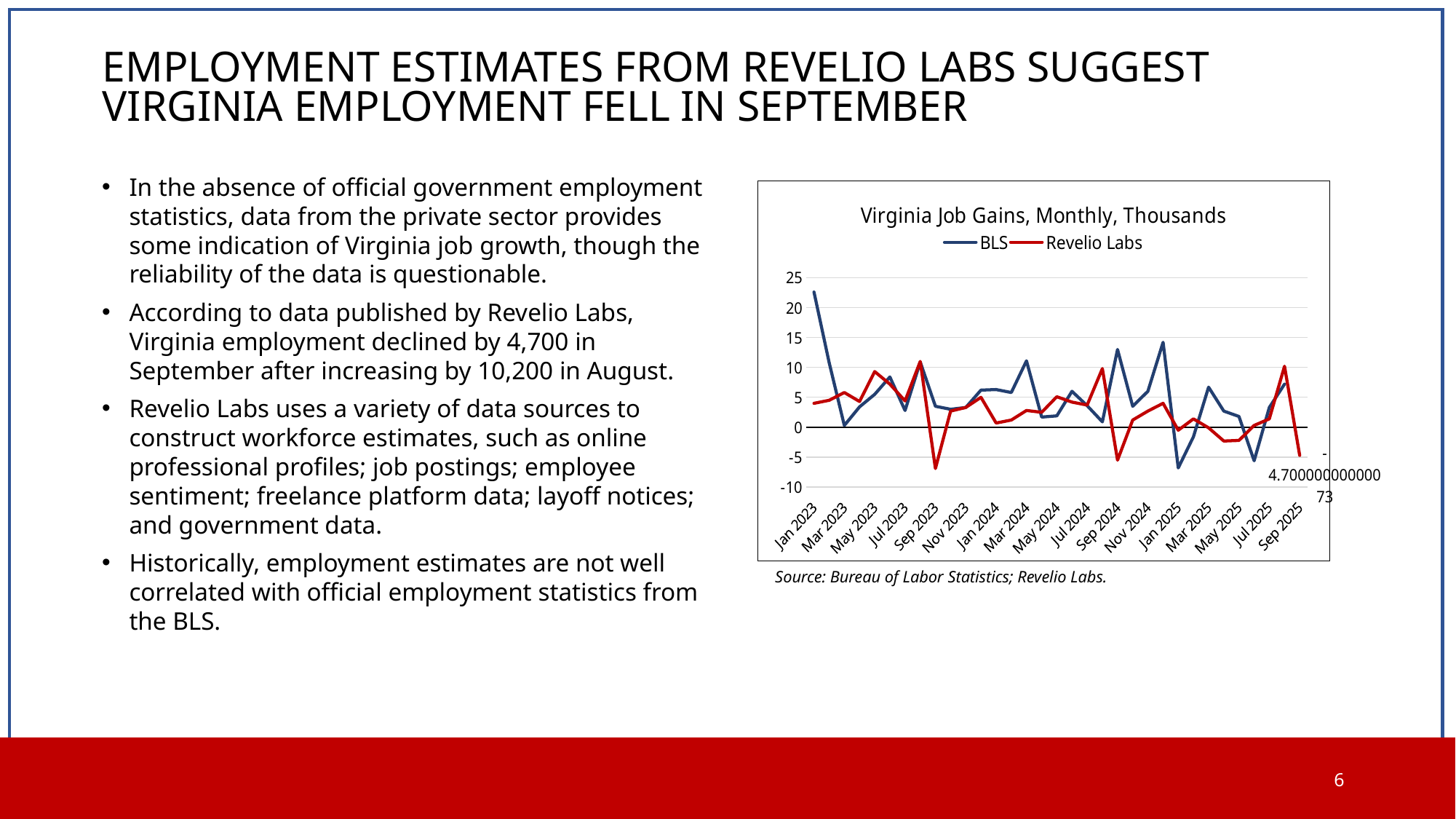
What colour is the Revelio Labs line in the chart? red What kind of chart is shown on the slide? line chart Which series reaches the highest value anywhere on the chart? BLS In Jan 2023, which series has the larger value, BLS or Revelio Labs? BLS Is the BLS value for Jan 2025 greater or less than 10? less Is the BLS value for Jan 2023 greater or less than 20? greater What value is printed as the data label at the end of the Revelio Labs line for Sep 2025? -4.70000000000073 What is the title of the chart? Virginia Job Gains, Monthly, Thousands Is the Revelio Labs value for Sep 2025 greater or less than 0? less How many month labels are shown on the x axis of the chart? 17 How many series does the legend of the chart list? 2